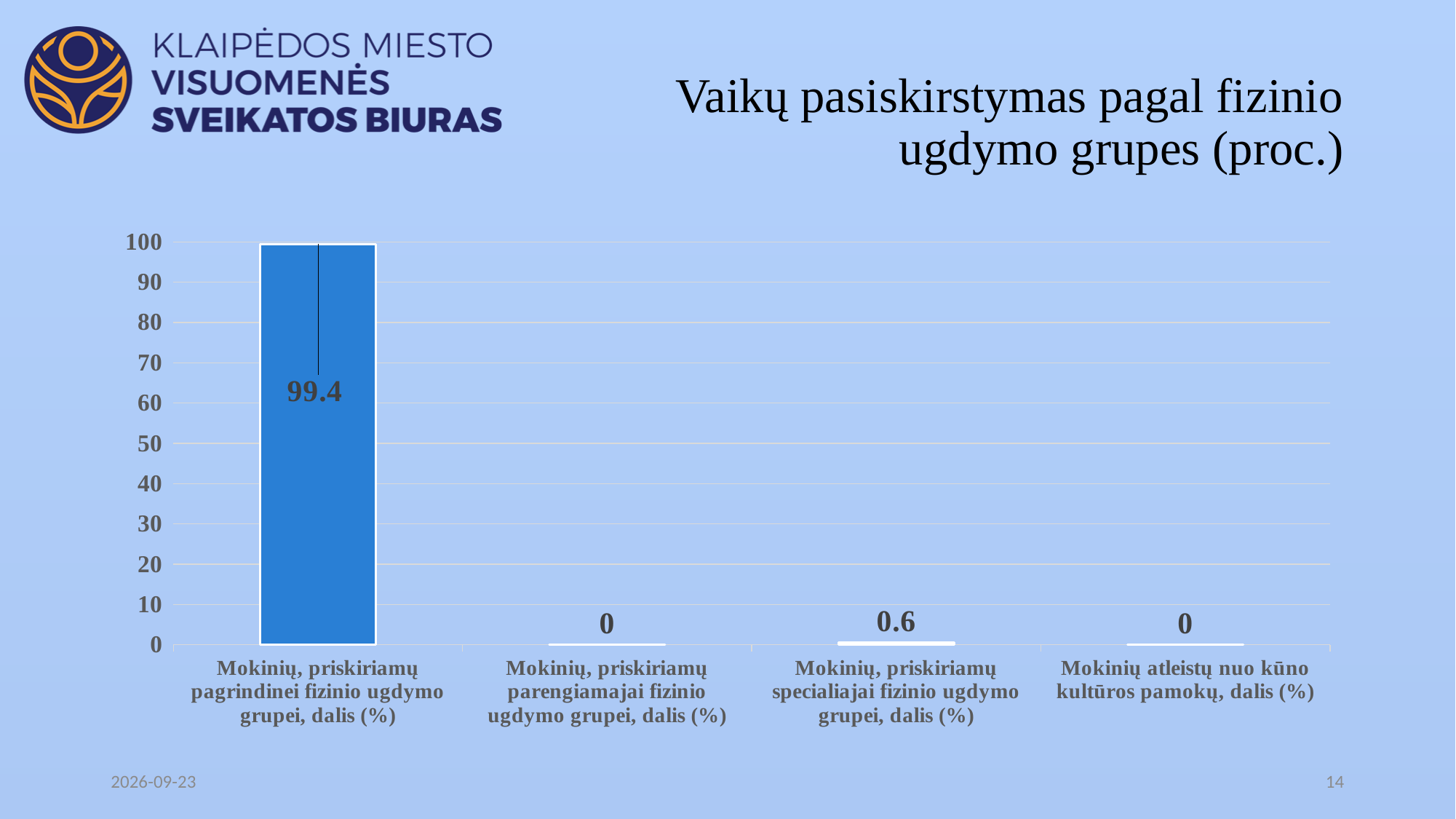
Which is larger: the value for the specialiajai fizinio ugdymo grupei or the value for the parengiamajai fizinio ugdymo grupei? Mokinių, priskiriamų specialiajai fizinio ugdymo grupei, dalis (%) How many categories are shown on the x axis? 4 What is the value for 'Mokinių, priskiriamų parengiamajai fizinio ugdymo grupei, dalis (%)'? 0 What is the highest value shown on the y axis? 100 What is the value for 'Mokinių, priskiriamų pagrindinei fizinio ugdymo grupei, dalis (%)'? 99.4 Which category has the highest value? Mokinių, priskiriamų pagrindinei fizinio ugdymo grupei, dalis (%) What kind of chart is shown on the slide? bar chart What is the value for 'Mokinių, priskiriamų specialiajai fizinio ugdymo grupei, dalis (%)'? 0.6 What is the value for 'Mokinių atleistų nuo kūno kultūros pamokų, dalis (%)'? 0 What is the difference between the values for the pagrindinei group and the specialiajai group? 98.8 Is the value for 'Mokinių, priskiriamų pagrindinei fizinio ugdymo grupei, dalis (%)' greater or less than 90? greater What is the title of the chart on the slide? Vaikų pasiskirstymas pagal fizinio ugdymo grupes (proc.)